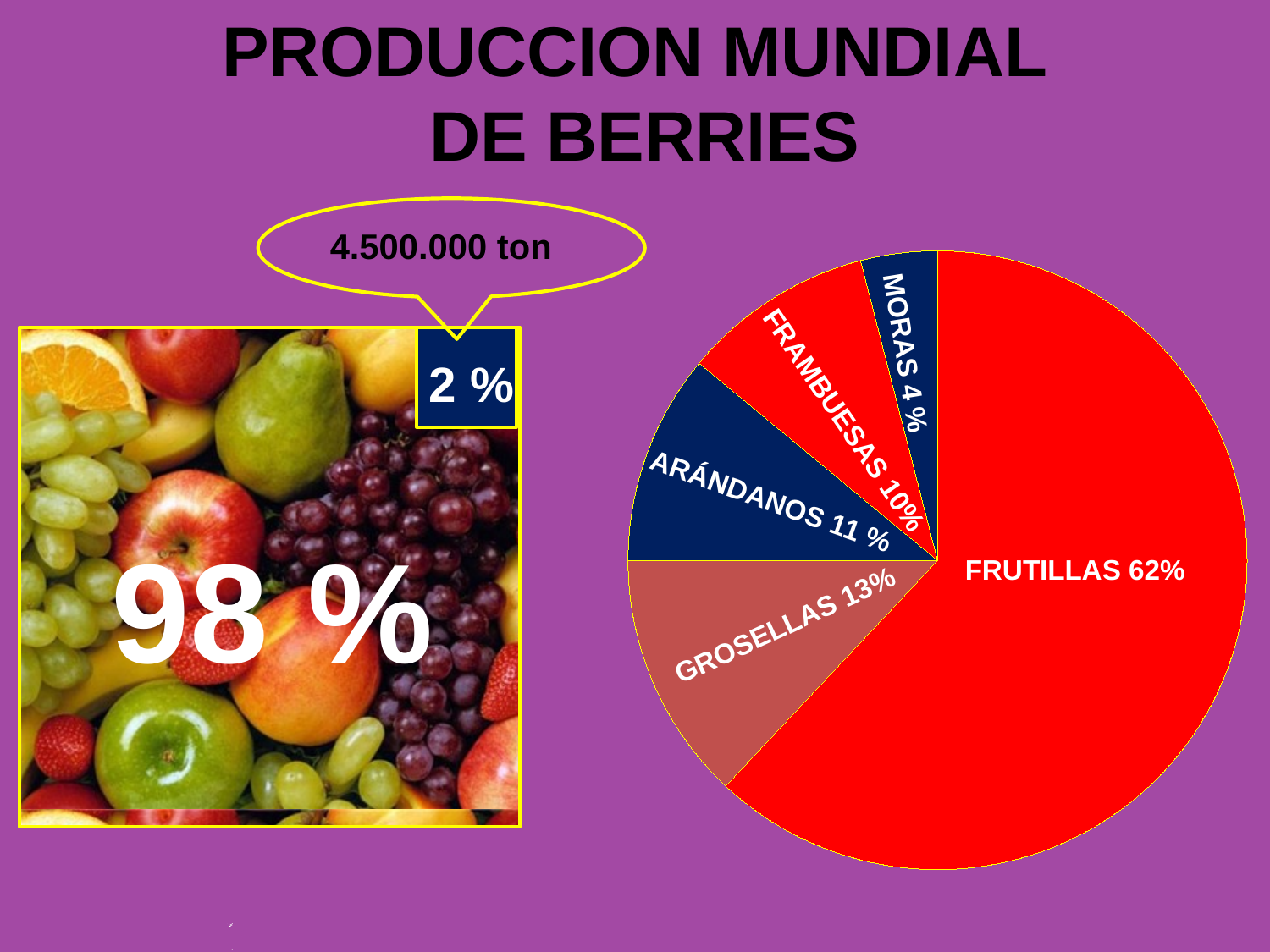
In the pie chart, what share is labelled for MORAS? 4 % Which slice of the pie chart is the smallest? MORAS What kind of chart is shown on the right of the slide? pie chart Which slice of the pie chart is the largest? FRUTILLAS In the pie chart, what share is labelled for FRUTILLAS? 62% In the pie chart, what share is labelled for ARÁNDANOS? 11 % What colour is the FRUTILLAS slice in the pie chart? red How many slices does the pie chart have? 5 In the pie chart, which is larger, GROSELLAS or FRAMBUESAS? GROSELLAS In the pie chart, what share is labelled for FRAMBUESAS? 10% In the pie chart, what is the difference in percentage points between FRUTILLAS and GROSELLAS? 49 In the pie chart, what share is labelled for GROSELLAS? 13%